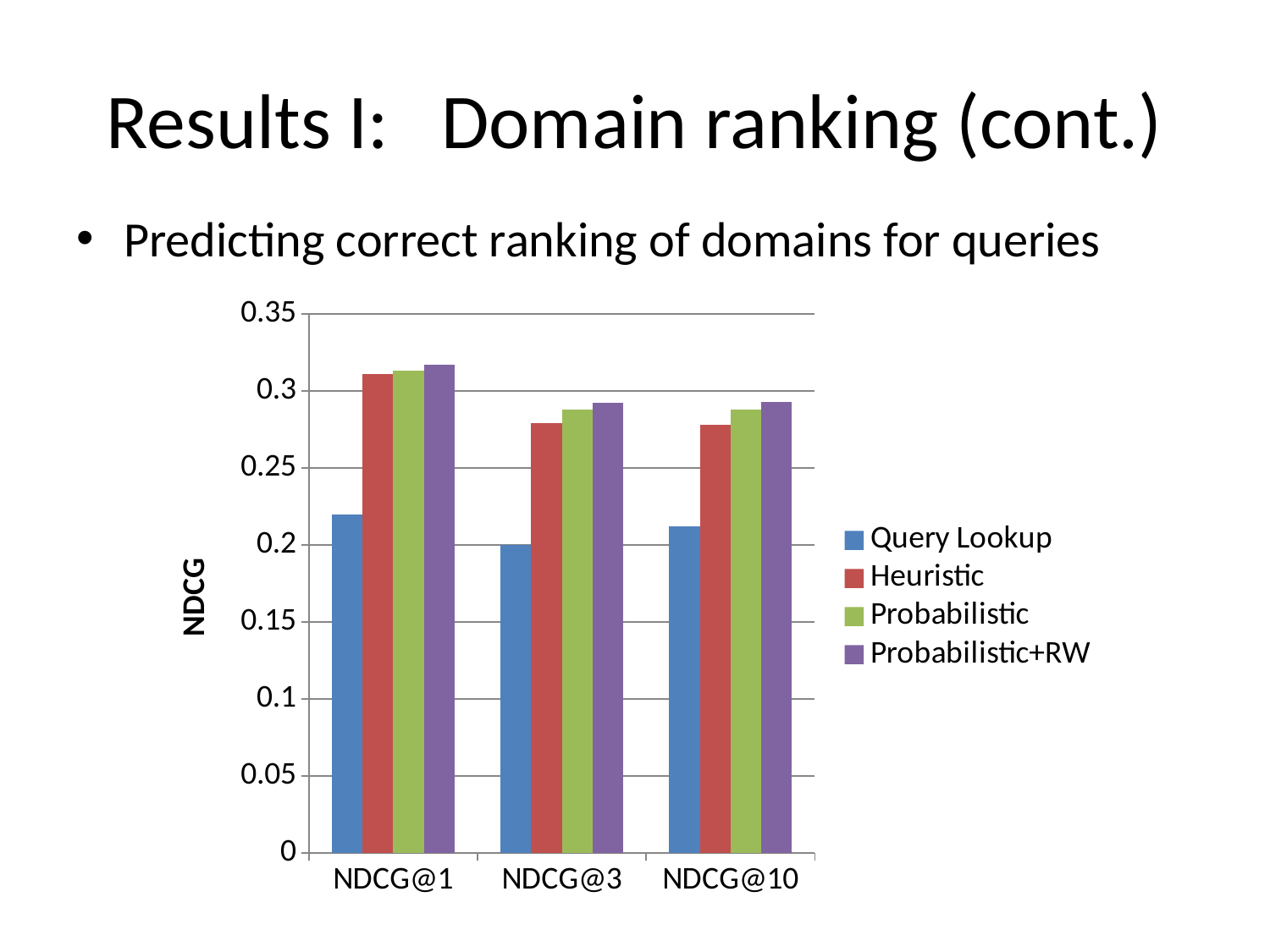
Is the value for Heuristic at NDCG@1 greater or less than 0.3? greater Is the value for Query Lookup at NDCG@1 greater or less than 0.25? less Which series has the lowest value for NDCG@1? Query Lookup Which is larger for Query Lookup: the value at NDCG@1 or at NDCG@3? NDCG@1 Which series has the lowest value for NDCG@10? Query Lookup How many series does the legend list? 4 Is the value for Heuristic at NDCG@10 greater or less than 0.25? greater What is the label on the y axis? NDCG What kind of chart is shown on the slide? bar chart Which is larger at NDCG@10: Query Lookup or Heuristic? Heuristic How many categories are shown on the x axis? 3